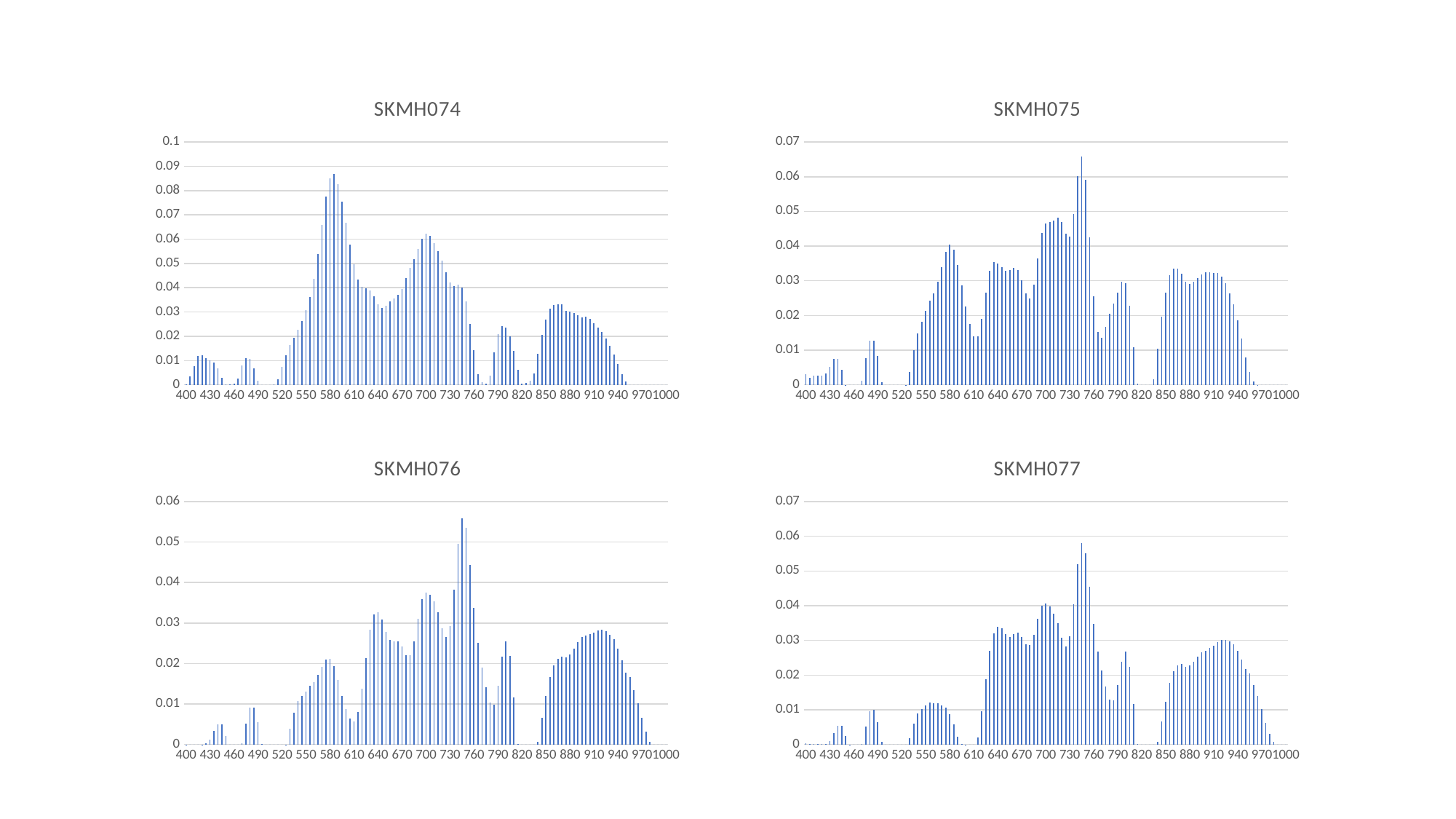
In the SKMH077 chart, is the tallest bar greater or less than 0.05? greater In the SKMH074 chart, which peak is taller: the one near 580 or the one near 700? the one near 580 In the SKMH077 chart, is the bar at 700 greater or less than 0.03? greater In the SKMH076 chart, is the tallest bar greater or less than 0.05? greater Which chart on the slide has a y axis that goes up to 0.06? SKMH076 What kind of chart is SKMH074? bar chart How many charts are shown on the slide? 4 What is the highest value shown on the y axis of the SKMH074 chart? 0.1